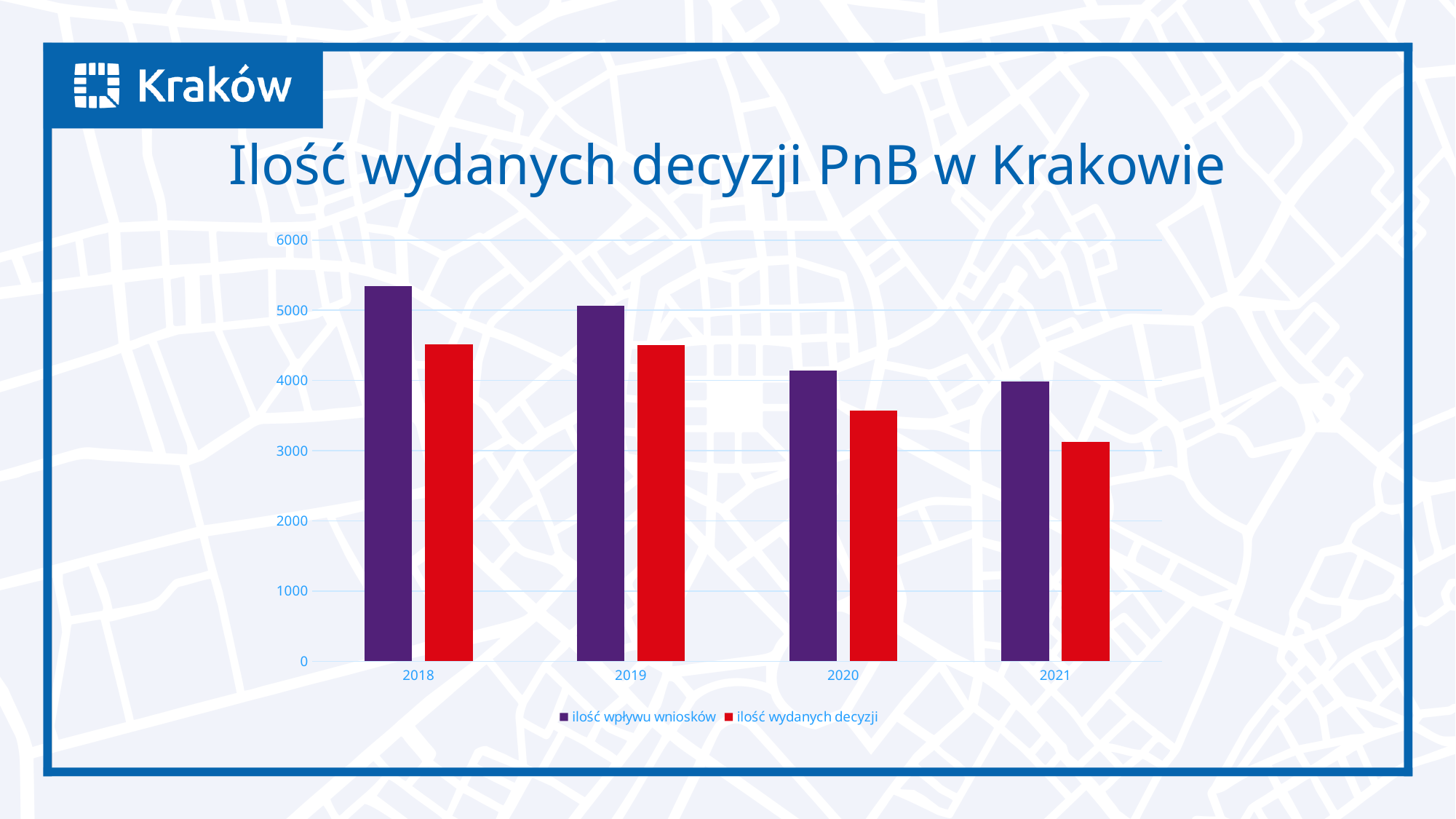
Which series is shown in red in the chart? ilość wydanych decyzji Does the value for 'ilość wpływu wniosków' rise or fall from 2018 to 2021? fall How many years are shown on the x axis of the chart? 4 In 2018, which is larger: 'ilość wpływu wniosków' or 'ilość wydanych decyzji'? ilość wpływu wniosków In which year is the value for 'ilość wpływu wniosków' the highest? 2018 How many series does the chart legend list? 2 What is the title of the chart? Ilość wydanych decyzji PnB w Krakowie In which year is the value for 'ilość wydanych decyzji' the lowest? 2021 Is the value for 'ilość wpływu wniosków' in 2018 greater or less than 5000? greater What kind of chart is shown on the slide? bar chart Is the value for 'ilość wydanych decyzji' in 2019 greater or less than 5000? less Is the value for 'ilość wydanych decyzji' in 2020 greater or less than 4000? less